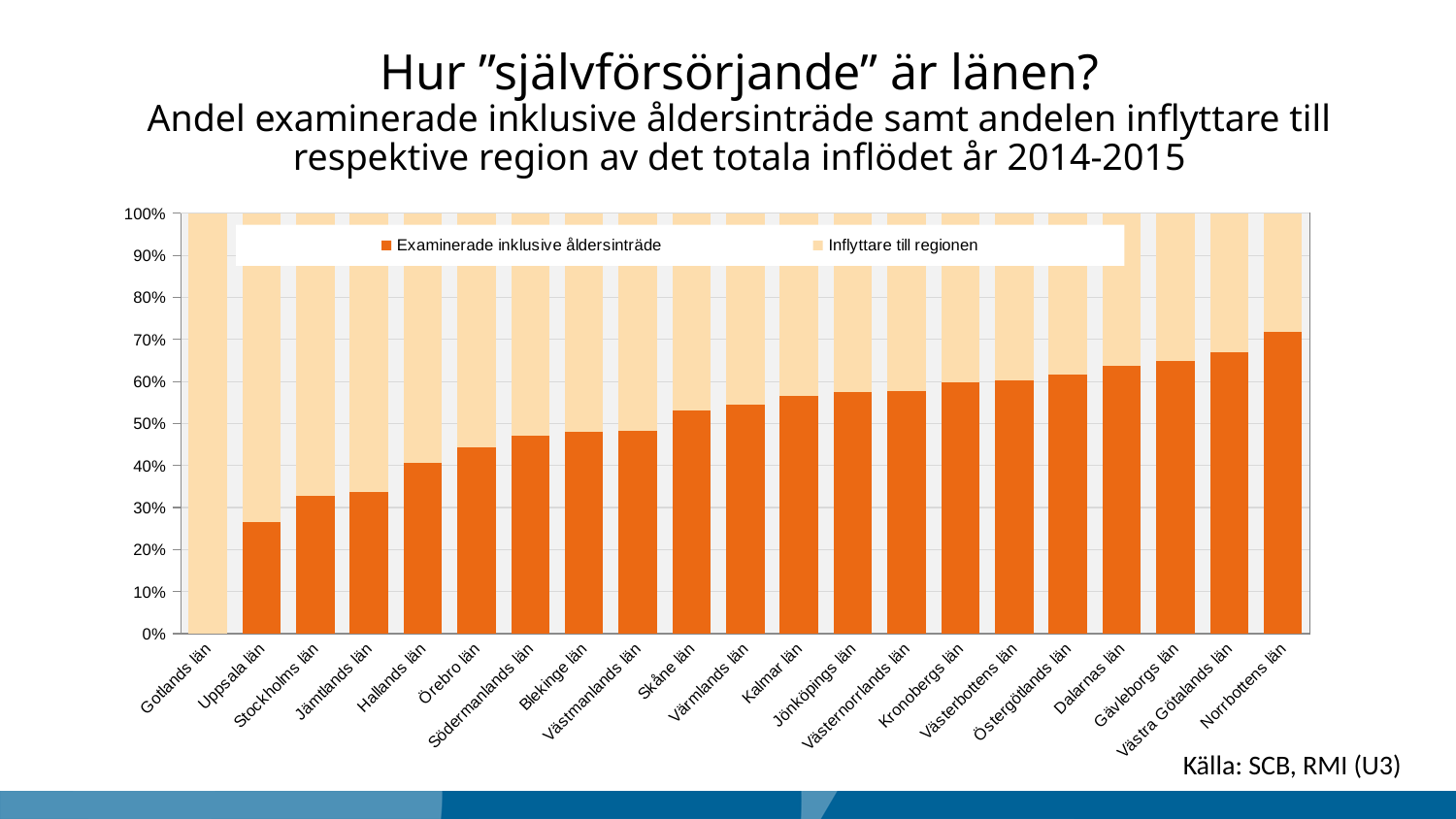
Which has a larger share of 'Examinerade inklusive åldersinträde', Kalmar län or Blekinge län? Kalmar län How many counties (län) are shown on the x axis? 21 Which county has the lowest share of 'Examinerade inklusive åldersinträde'? Gotlands län What kind of chart is shown on the slide? Stacked bar chart Is the 'Examinerade inklusive åldersinträde' value for Uppsala län greater or less than 30%? less How many series does the legend list? 2 Is the 'Examinerade inklusive åldersinträde' value for Norrbottens län greater or less than 70%? greater Which colour represents 'Inflyttare till regionen' in the legend? Light orange Do the 'Examinerade inklusive åldersinträde' values rise or fall from left to right along the x axis? Rise Is the 'Examinerade inklusive åldersinträde' value for Skåne län greater or less than 50%? greater Which county has the highest share of 'Examinerade inklusive åldersinträde'? Norrbottens län